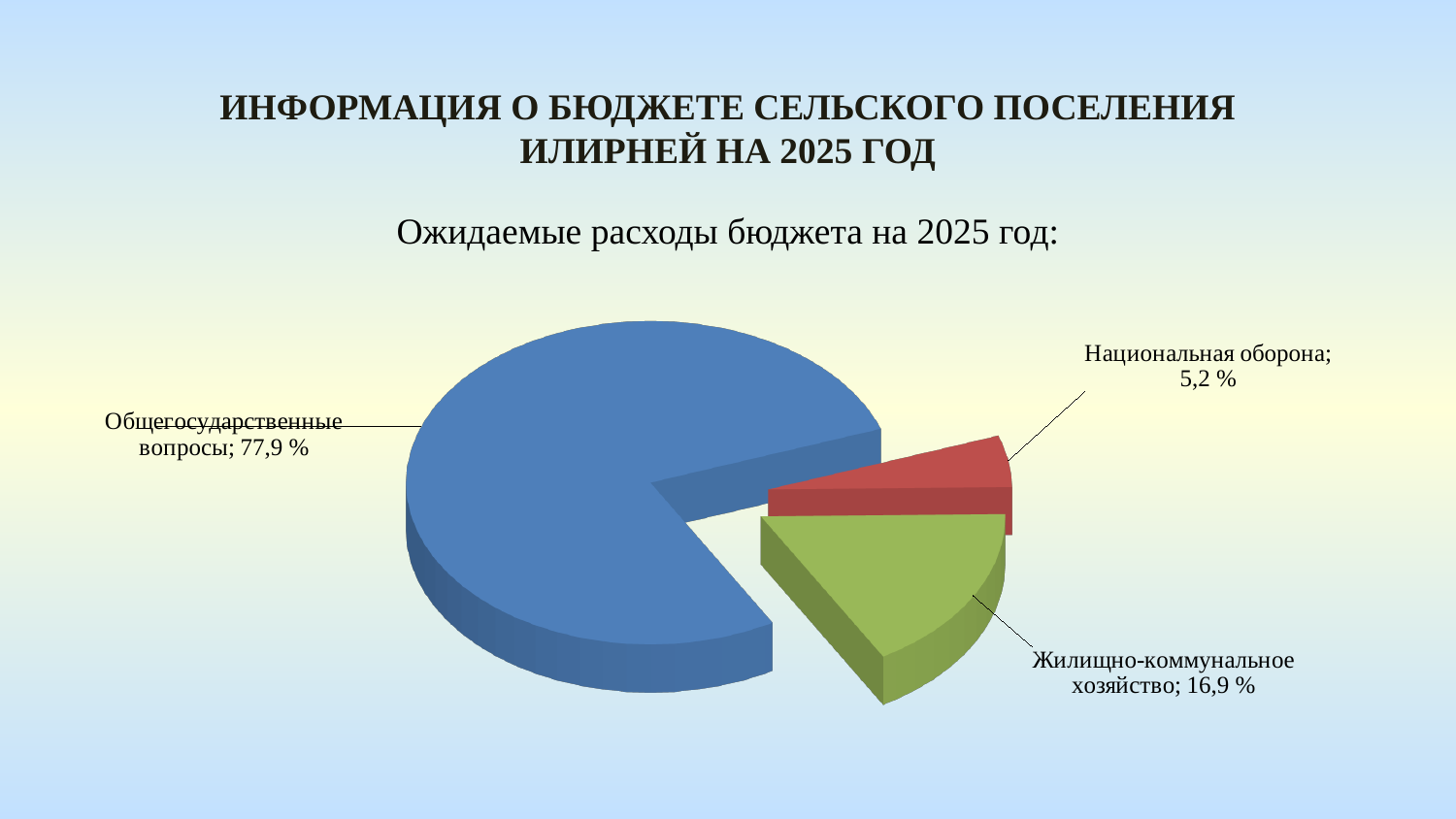
What kind of chart is shown on the slide? Pie chart What is the difference in percentage points between the shares for Общегосударственные вопросы and Жилищно-коммунальное хозяйство? 61 percentage points What share of expected 2025 budget expenditures goes to Национальная оборона? 5,2 % Which is larger: the share for Жилищно-коммунальное хозяйство or the share for Национальная оборона? Жилищно-коммунальное хозяйство What is the difference in percentage points between the shares for Жилищно-коммунальное хозяйство and Национальная оборона? 11,7 percentage points What share of expected 2025 budget expenditures goes to Общегосударственные вопросы? 77,9 % What share of expected 2025 budget expenditures goes to Жилищно-коммунальное хозяйство? 16,9 % What is the subtitle above the pie chart? Ожидаемые расходы бюджета на 2025 год: Which expenditure category has the largest share of the pie? Общегосударственные вопросы Which expenditure category has the smallest share of the pie? Национальная оборона How many categories are shown in the pie chart? 3 What colour is the slice for Национальная оборона? Red